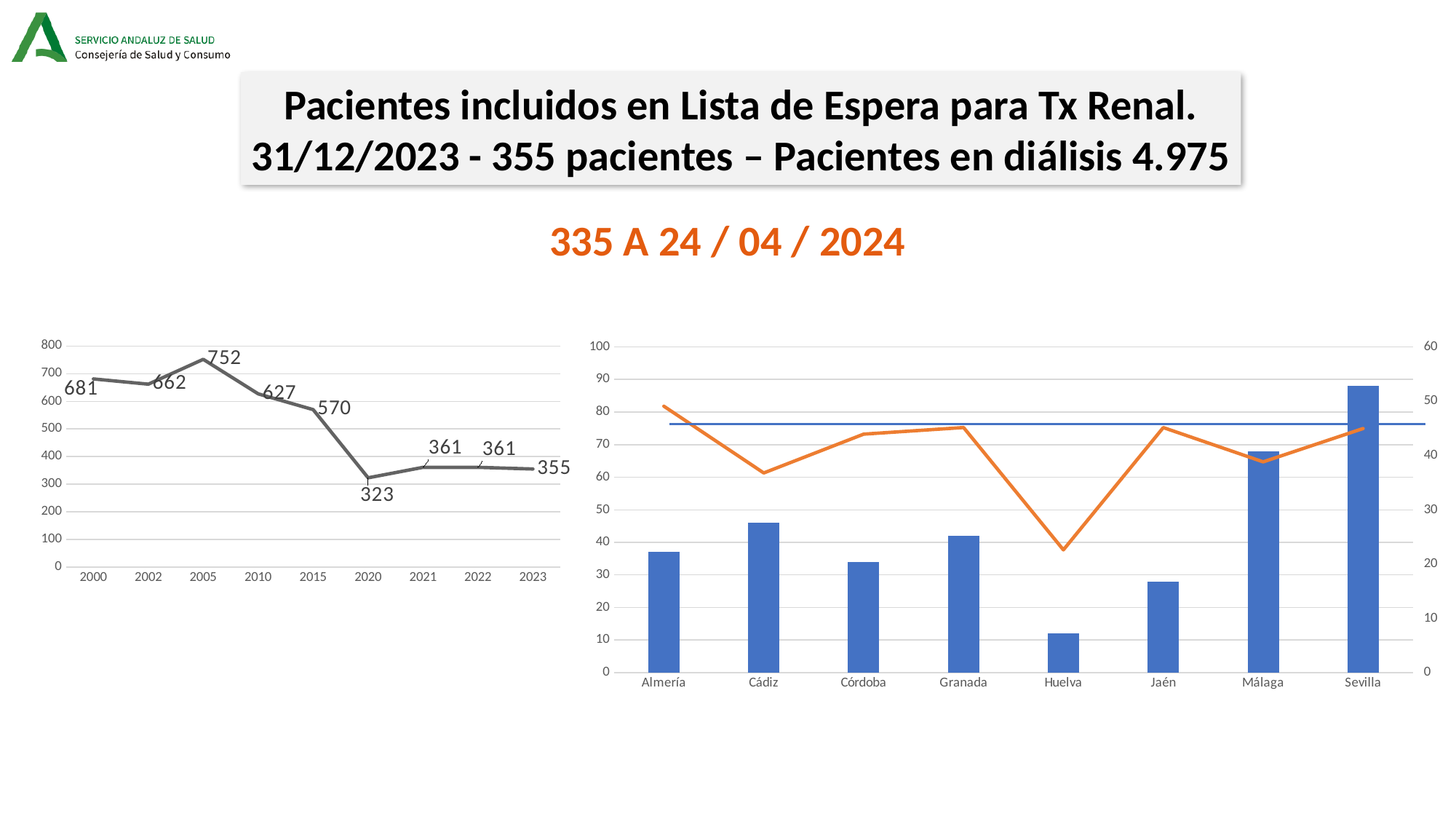
In the line chart on the left, which year has the lowest value? 2020 In the line chart on the left, what is the value for 2005? 752 In the line chart on the left, which is larger, the value for 2000 or the value for 2002? 2000 In the chart on the right, which province has the shortest bar? Huelva In the chart on the right, which province has the tallest bar? Sevilla In the line chart on the left, what is the difference between the values for 2015 and 2020? 247 In the line chart on the left, how many years are plotted on the x axis? 9 In the line chart on the left, which year has the highest value? 2005 In the chart on the right, is the bar value for Málaga greater or less than 60? greater In the line chart on the left, what is the value for 2020? 323 In the chart on the right, how many provinces are shown on the x axis? 8 In the line chart on the left, does the value rise or fall between 2005 and 2020? fall